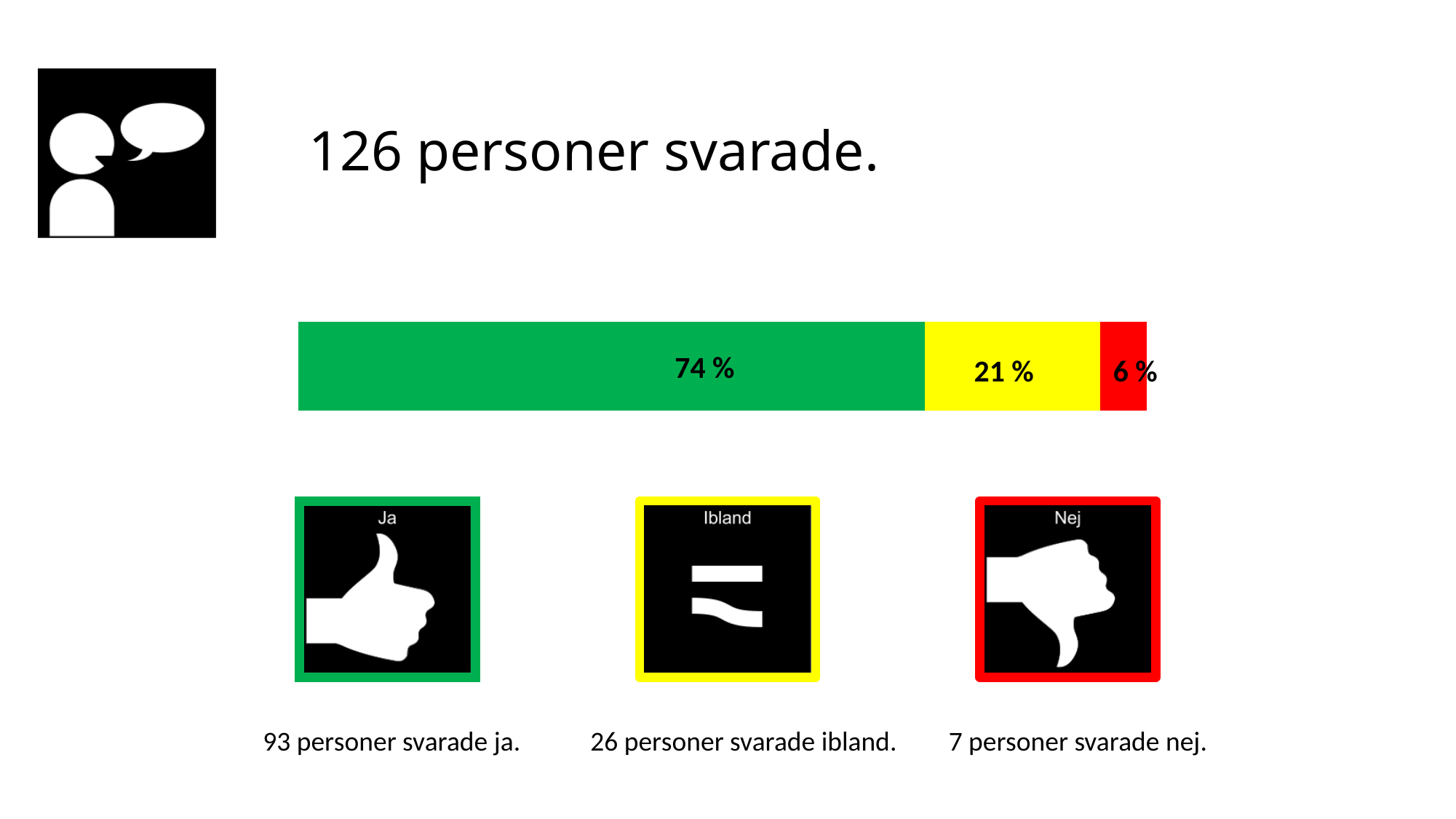
How many segments does the stacked bar have? 3 Which response category has the smallest share of the bar? Nej What percentage is shown for the green segment (Ja) of the bar? 74 % What colour is the segment representing Nej? Red What kind of chart is shown on the slide? Stacked bar chart Which segment is larger, Ibland or Nej? Ibland What percentage is shown for the yellow segment (Ibland) of the bar? 21 % How many people answered in total, according to the slide? 126 Which response category has the largest share of the bar? Ja What is the difference in percentage points between the Ja segment and the Ibland segment? 53 % What is the difference in percentage points between the Ibland segment and the Nej segment? 15 % What percentage is shown for the red segment (Nej) of the bar? 6 %